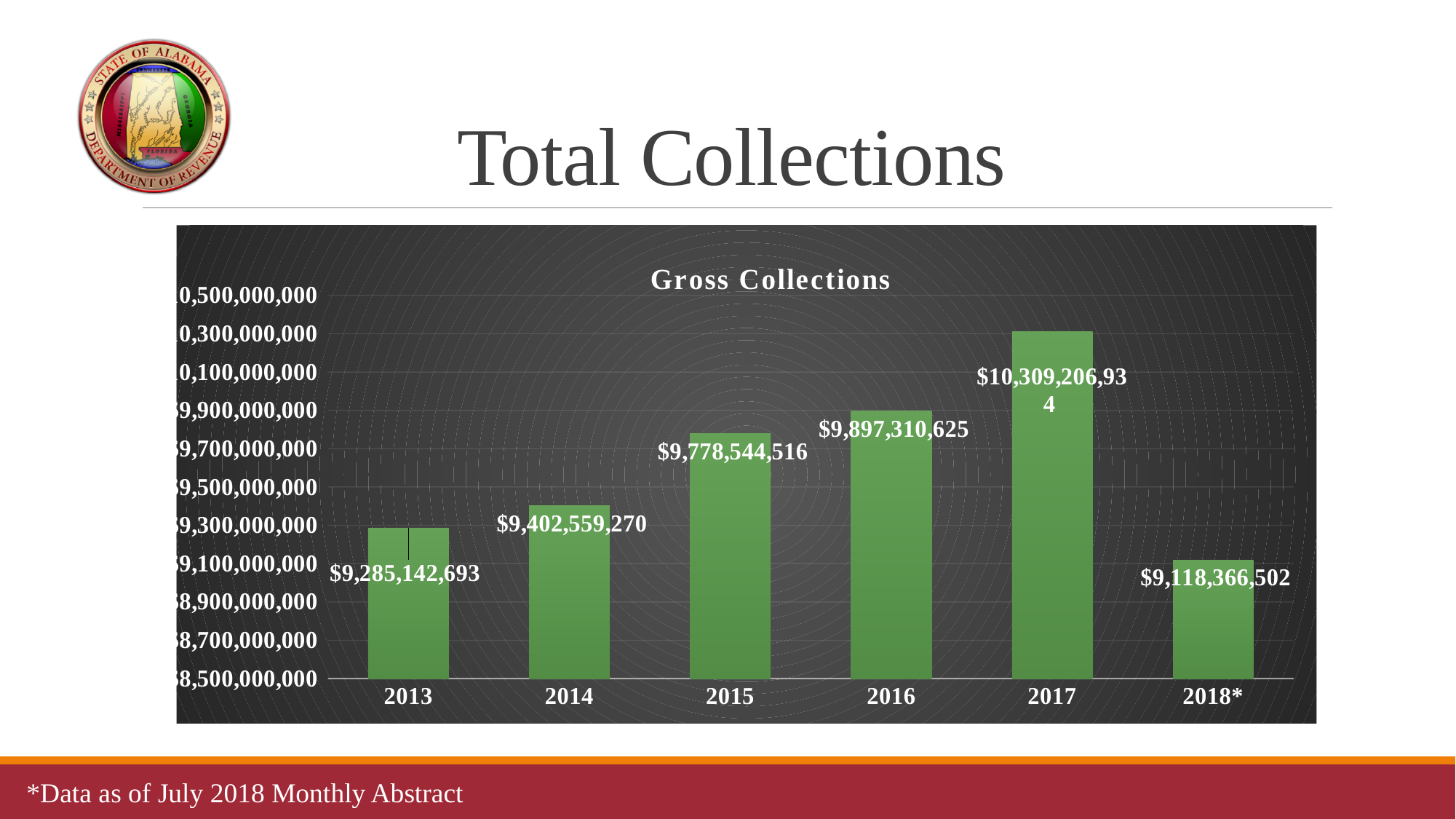
Which year has the lowest Gross Collections? 2018* What is the value of Gross Collections for 2018*? $9,118,366,502 Which year has the highest Gross Collections? 2017 What is the value of Gross Collections for 2015? $9,778,544,516 What is the value of Gross Collections for 2017? $10,309,206,934 Is the value for 2015 greater or less than $9,500,000,000? greater What kind of chart is shown on the slide? Bar chart Which year has larger Gross Collections, 2014 or 2016? 2016 How many years are shown on the x axis of the chart? 6 What is the difference between Gross Collections in 2017 and 2016? $411,896,309 What is the difference between Gross Collections in 2014 and 2013? $117,416,577 Do Gross Collections rise or fall from 2013 to 2017? Rise